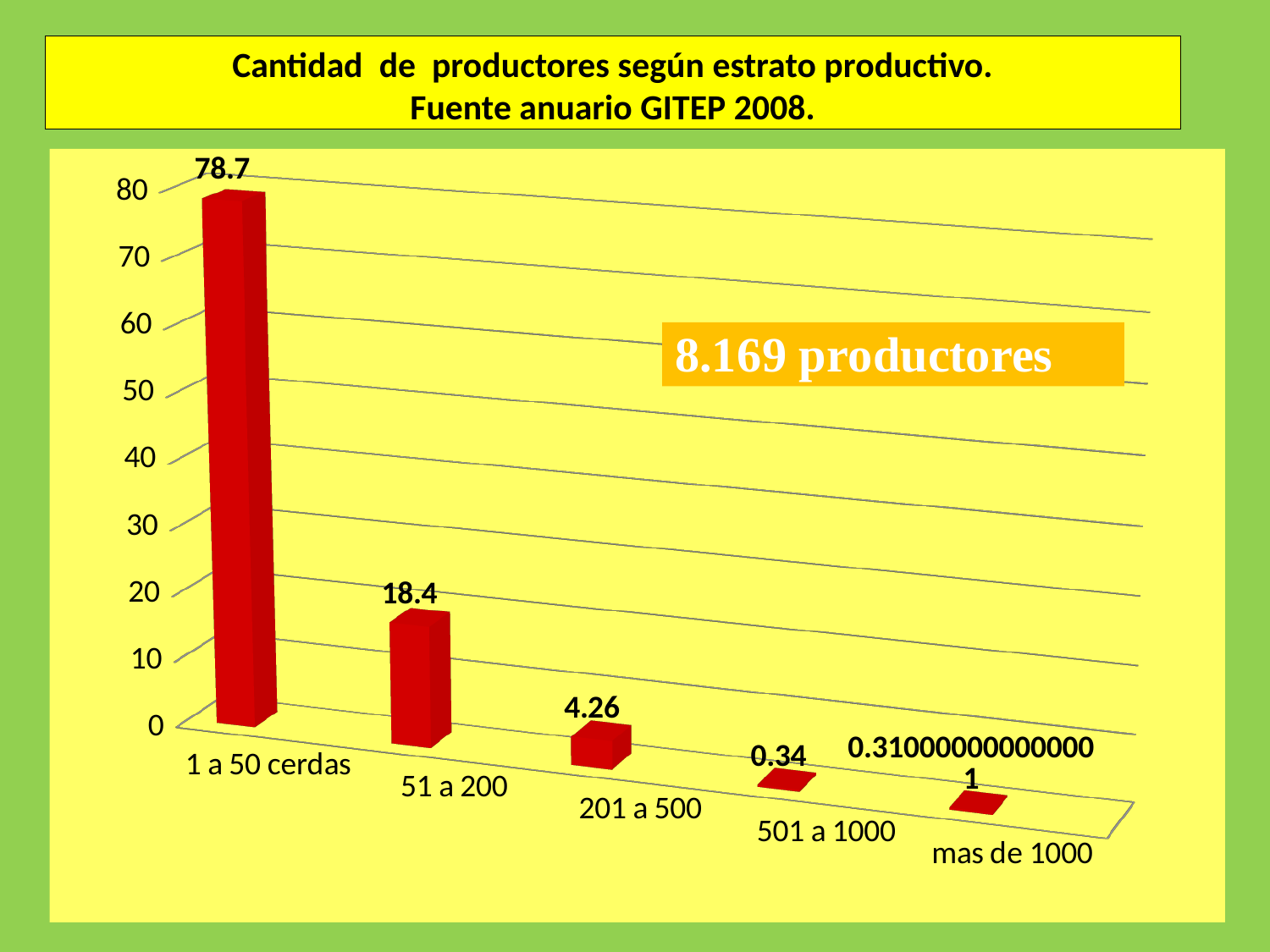
Which category has the lowest value? mas de 1000 What is the difference between the values for '1 a 50 cerdas' and '51 a 200'? 60.3 Which is larger, the value for '201 a 500' or the value for '501 a 1000'? 201 a 500 What is the difference between the values for '51 a 200' and '201 a 500'? 14.14 Which category has the highest value? 1 a 50 cerdas What is the value for the category '51 a 200'? 18.4 How many categories are shown on the x axis? 5 What is the value for the category '201 a 500'? 4.26 What is the value for the category '1 a 50 cerdas'? 78.7 What is the value for the category '501 a 1000'? 0.34 Is the value for '1 a 50 cerdas' greater or less than 70? greater What kind of chart is shown on the slide? Bar chart